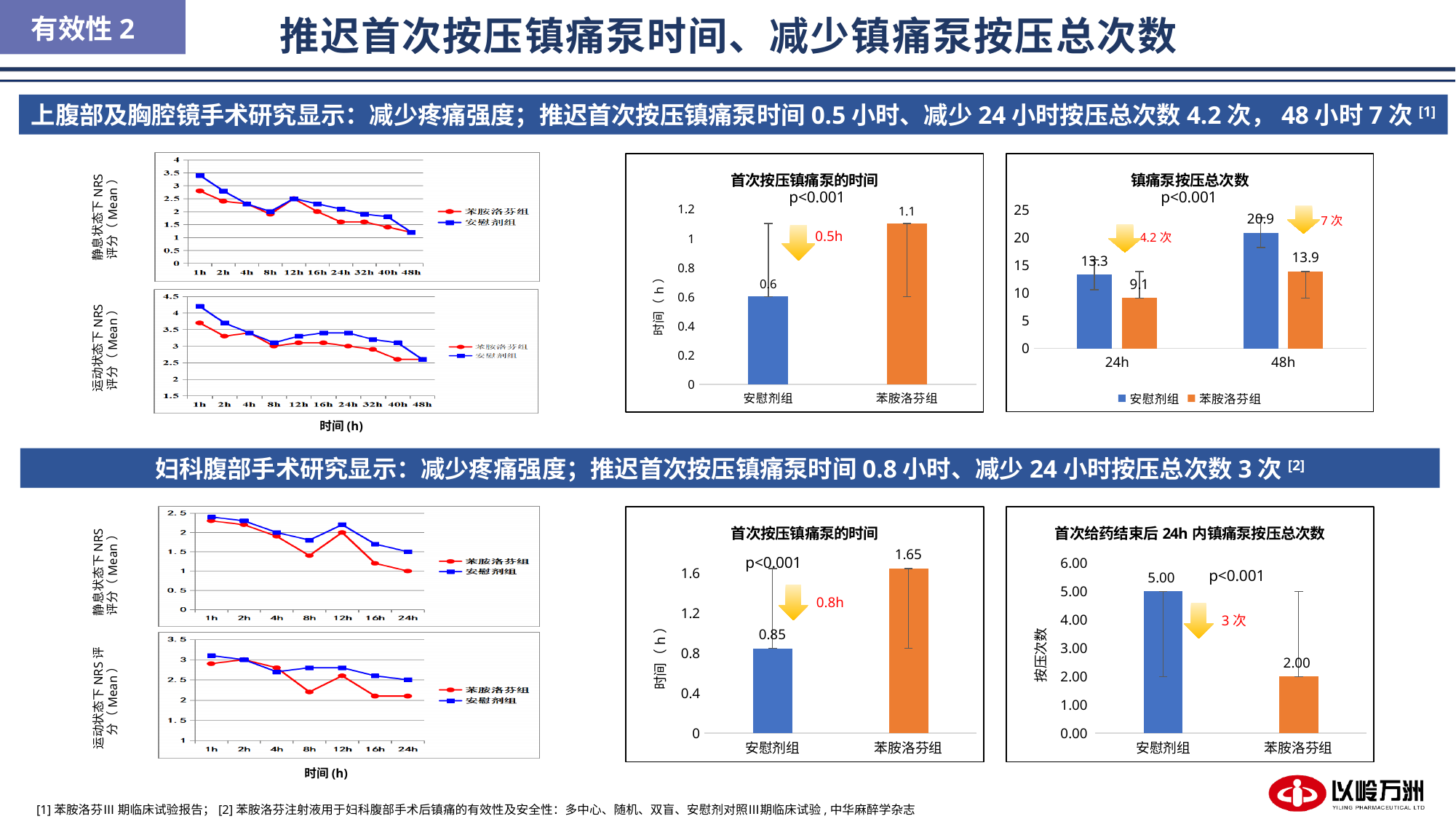
In the upper '首次按压镇痛泵的时间' bar chart, what is the value for 苯胺洛芬组? 1.1 In the lower '首次按压镇痛泵的时间' bar chart, what is the value for 苯胺洛芬组? 1.65 In the upper '首次按压镇痛泵的时间' bar chart, what is the value for 安慰剂组? 0.6 In the '首次给药结束后 24h 内镇痛泵按压总次数' chart, what is the value for 苯胺洛芬组? 2.00 In the '镇痛泵按压总次数' bar chart, which group has the higher value at 48h? 安慰剂组 In the '镇痛泵按压总次数' bar chart, how many series does the legend list? 2 In the upper '首次按压镇痛泵的时间' bar chart, what is the difference between 苯胺洛芬组 and 安慰剂组? 0.5 What kind of chart is the '首次给药结束后 24h 内镇痛泵按压总次数' chart? bar chart In the '镇痛泵按压总次数' bar chart, what is the value for 安慰剂组 at 48h? 20.9 In the lower '首次按压镇痛泵的时间' bar chart, what is the value for 安慰剂组? 0.85 In the '镇痛泵按压总次数' bar chart, what is the value for 苯胺洛芬组 at 24h? 9.1 In the '镇痛泵按压总次数' bar chart, what is the difference between 安慰剂组 and 苯胺洛芬组 at 24h? 4.2